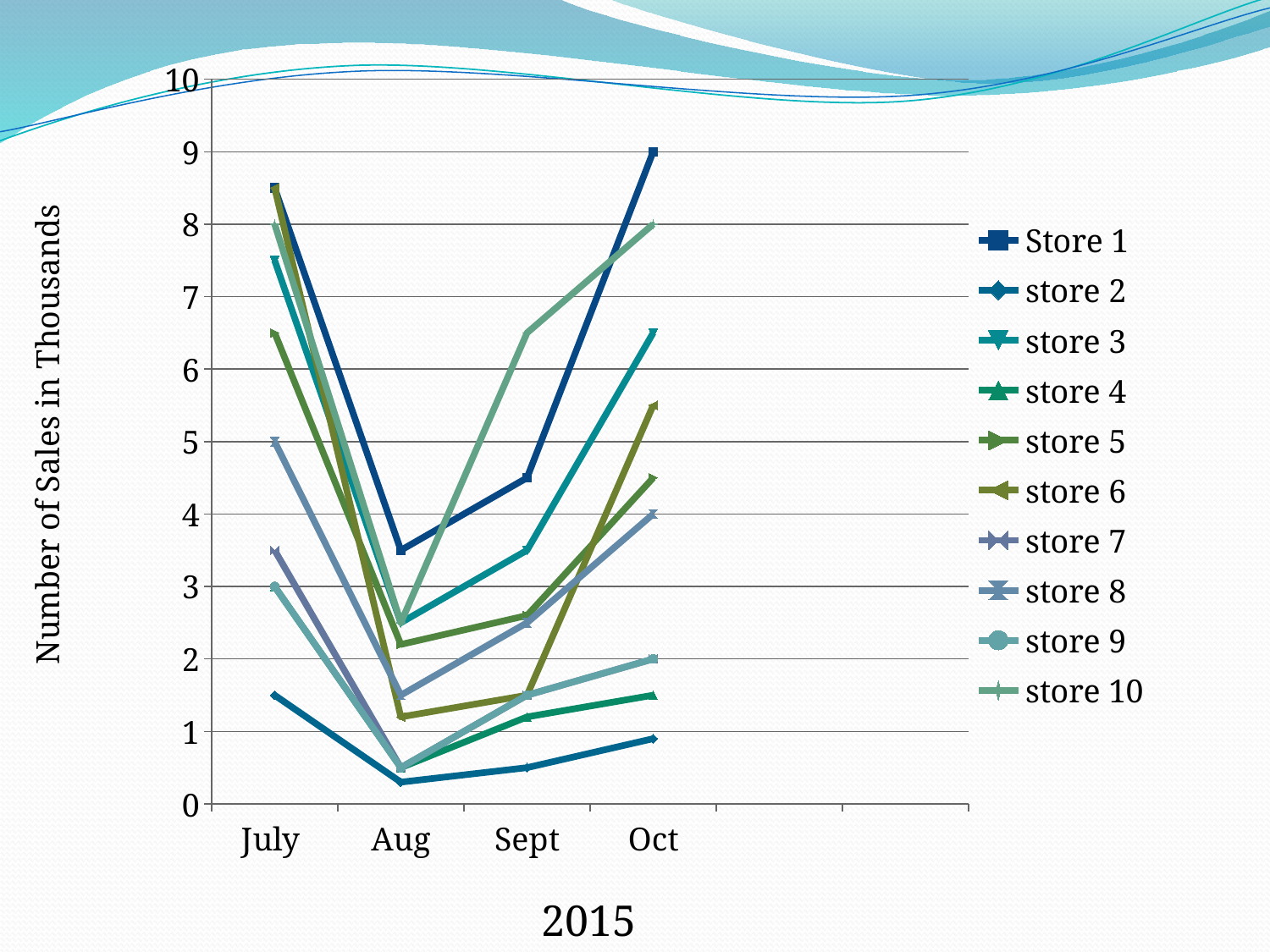
How many months are shown on the x axis? 4 Which store has the highest value in Oct? Store 1 What is the value for store 9 in July? 3 What is the value for store 10 in Oct? 8 What is the y-axis title of the chart? Number of Sales in Thousands What is the value for Store 1 in Oct? 9 Is the value for store 3 in July greater or less than 7? greater How many series does the legend list? 10 Which is larger in Sept, Store 1 or store 10? store 10 What kind of chart is shown on the slide? line chart Is the value for store 2 in Aug greater or less than 1? less Which store has the lowest value in Oct? store 2